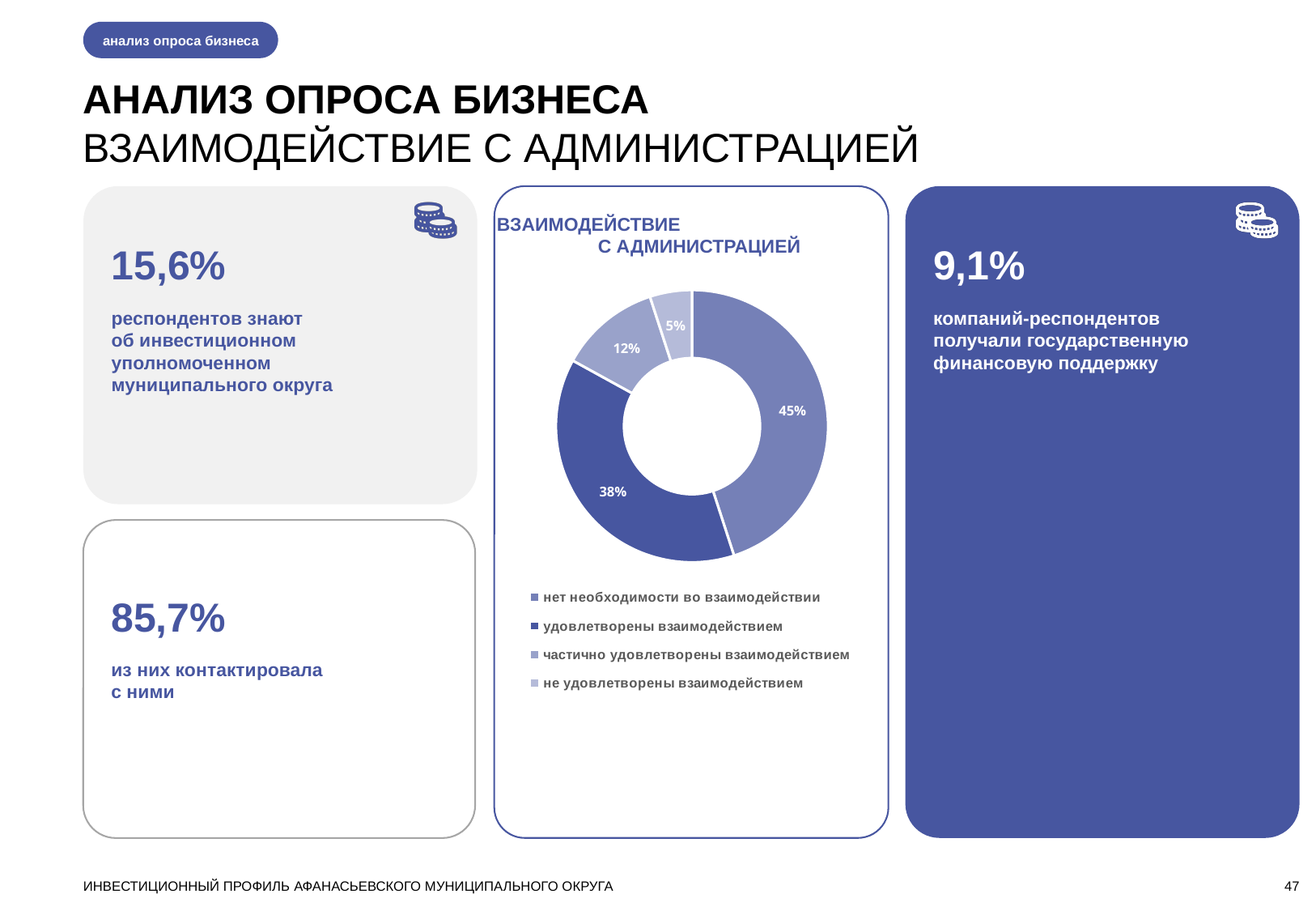
Which is larger: the share for "частично удовлетворены взаимодействием" or for "не удовлетворены взаимодействием"? частично удовлетворены взаимодействием What is the combined share of "удовлетворены взаимодействием" and "частично удовлетворены взаимодействием"? 50% Which category has the largest slice in the chart? нет необходимости во взаимодействии How many categories does the chart legend list? 4 Which category has the smallest slice in the chart? не удовлетворены взаимодействием What type of chart is shown on the slide? Pie (donut) chart What share of respondents answered "не удовлетворены взаимодействием"? 5% What is the difference between the shares for "нет необходимости во взаимодействии" and "удовлетворены взаимодействием"? 7% What share of respondents answered "удовлетворены взаимодействием"? 38% What share of respondents answered "нет необходимости во взаимодействии"? 45% What share of respondents answered "частично удовлетворены взаимодействием"? 12% What is the title of the chart? ВЗАИМОДЕЙСТВИЕ С АДМИНИСТРАЦИЕЙ